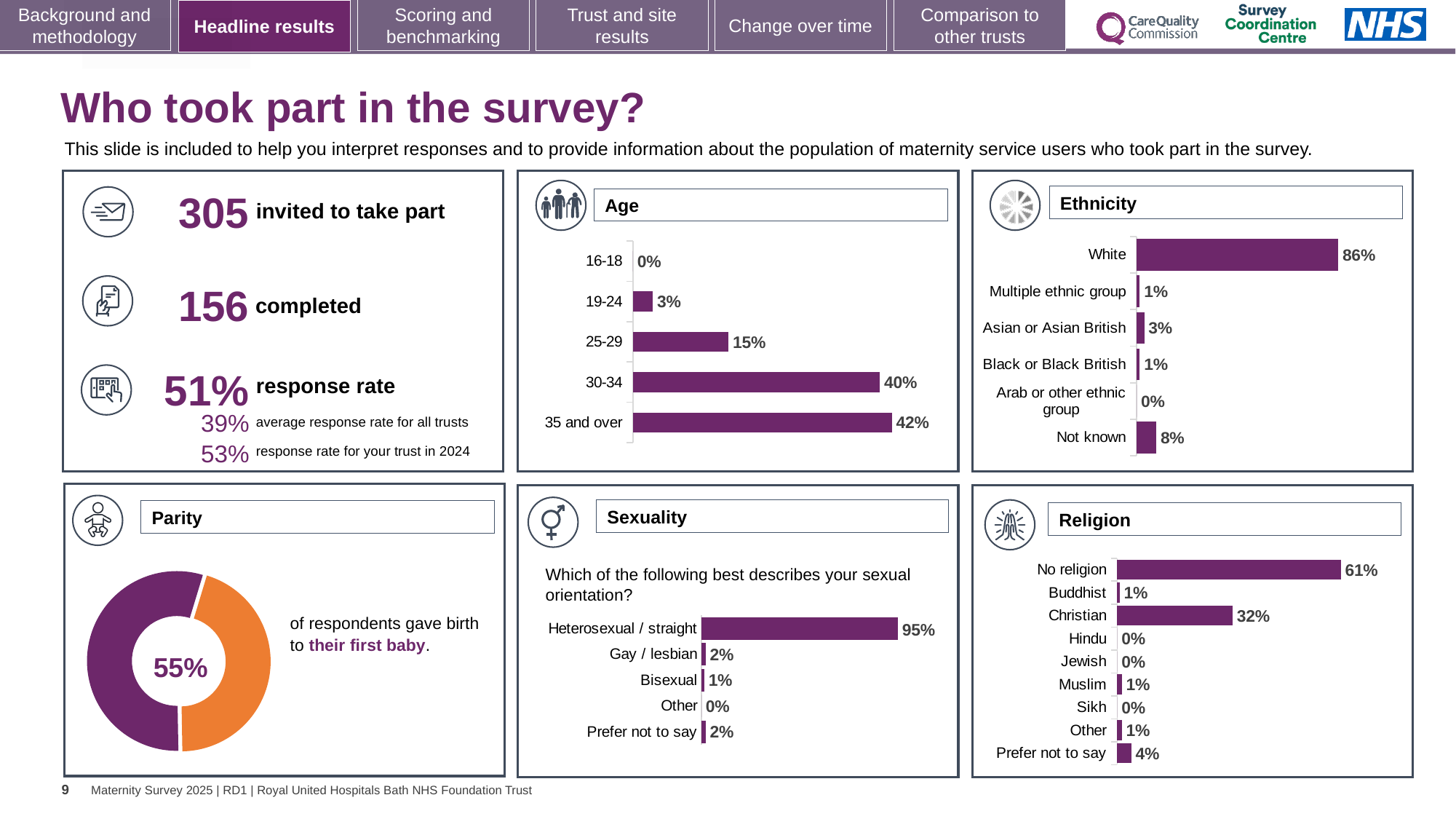
What kind of chart is the Parity chart? Doughnut chart In the Age chart, what is the difference between the 35 and over group and the 25-29 group? 27% In the Ethnicity chart, what percentage of respondents were White? 86% In the Ethnicity chart, what percentage of respondents were Not known? 8% In the Age chart, what percentage of respondents were aged 30-34? 40% In the Sexuality chart, what percentage of respondents answered Heterosexual / straight? 95% In the Age chart, which age group has the highest percentage? 35 and over In the Ethnicity chart, which is larger: Asian or Asian British or Black or Black British? Asian or Asian British How many age groups are shown in the Age chart? 5 In the Parity chart, what percentage of respondents gave birth to their first baby? 55% In the Religion chart, what percentage of respondents were Christian? 32% In the Religion chart, what is the difference between No religion and Christian? 29%